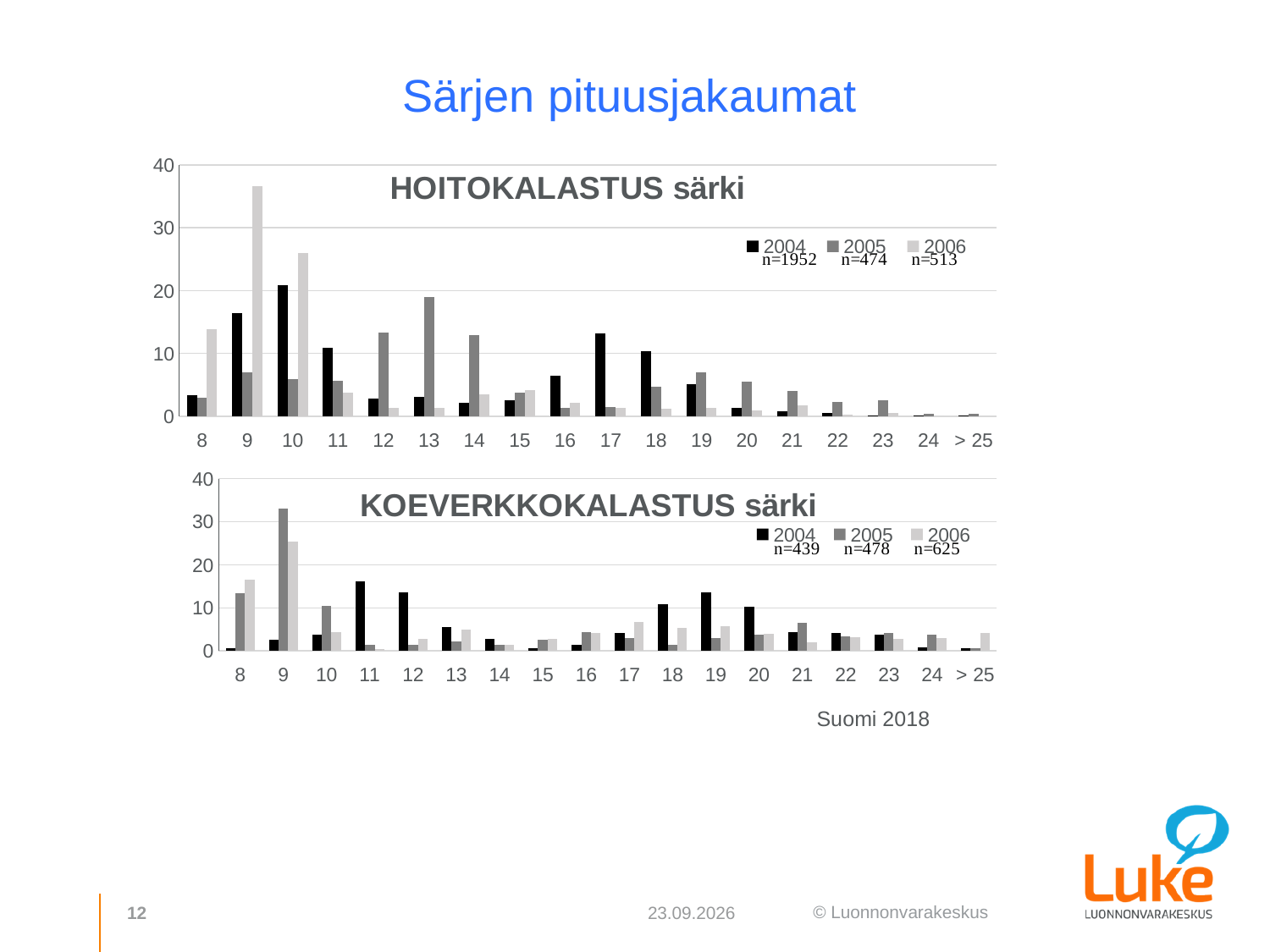
How many series does the legend of the KOEVERKKOKALASTUS särki chart list? 3 In the HOITOKALASTUS särki chart, at length 13, which is larger: the 2004 value or the 2005 value? 2005 In the HOITOKALASTUS särki chart, is the 2006 value at length 9 greater or less than 30? greater In the KOEVERKKOKALASTUS särki chart, at which length is the 2005 bar highest? 9 In the HOITOKALASTUS särki chart, which year has the tallest bar at length 9? 2006 In the KOEVERKKOKALASTUS särki chart, is the 2004 value at length 11 greater or less than 10? greater How many length categories are shown on the x axis of the HOITOKALASTUS särki chart? 18 What kind of chart is the HOITOKALASTUS särki chart? bar chart In the HOITOKALASTUS särki chart, is the 2005 value at length 13 greater or less than 10? greater In the KOEVERKKOKALASTUS särki chart, at length 11, which is larger: the 2004 value or the 2005 value? 2004 In the HOITOKALASTUS särki chart legend, what sample size (n) is given for 2004? n=1952